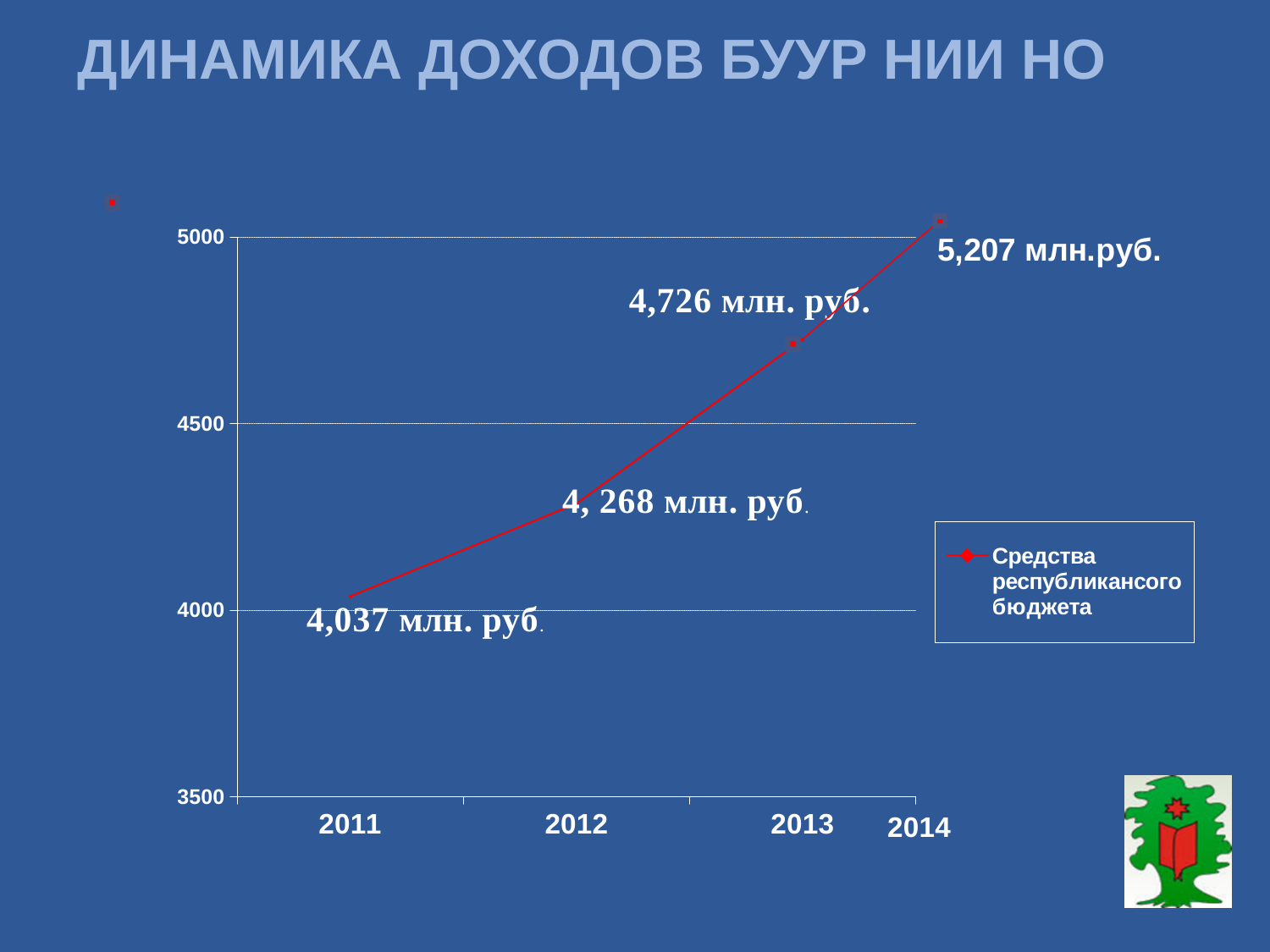
Which year has the lowest value? 2011 What is the value for 2012? 4, 268 млн. руб. What is the value for 2013? 4,726 млн. руб. What is the value for 2014? 5,207 млн.руб. What is the value for 2011? 4,037 млн. руб. Is the value for 2013 greater or less than 4500? greater What is the difference between the values for 2014 and 2011? 1,170 млн. руб. Which is larger, the value for 2012 or the value for 2013? 2013 How many years are plotted on the x axis? 4 Do the values rise or fall from 2011 to 2014? rise Which year has the highest value? 2014 What type of chart is shown on the slide? line chart